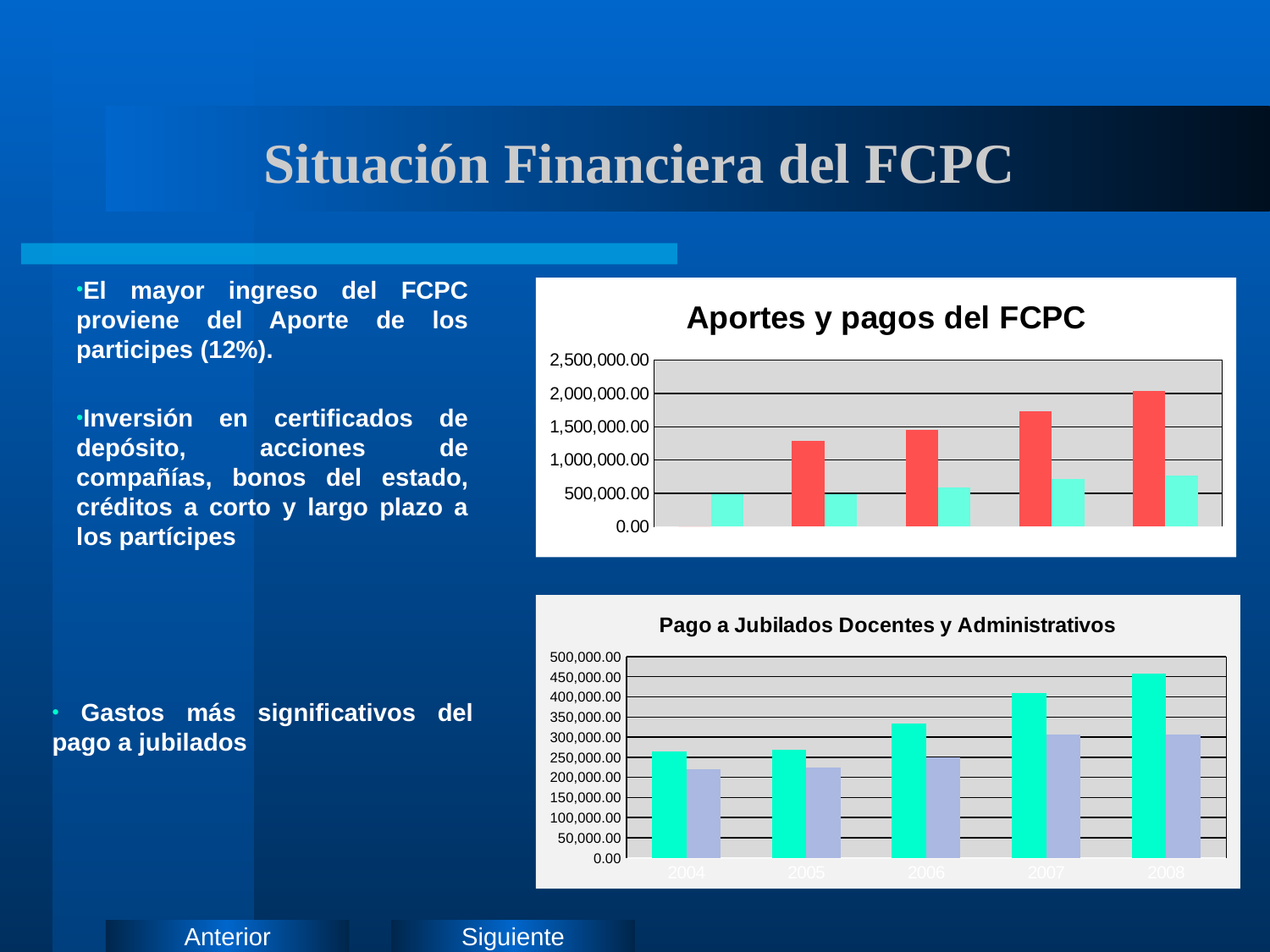
What kind of chart is the 'Aportes y pagos del FCPC' chart? Bar chart In the 'Pago a Jubilados Docentes y Administrativos' chart, which year has the tallest cyan bar? 2008 In the 'Pago a Jubilados Docentes y Administrativos' chart, how many years are shown on the x axis? 5 In the 'Aportes y pagos del FCPC' chart, is the red bar in the rightmost group greater or less than 1,500,000.00? greater In the 'Pago a Jubilados Docentes y Administrativos' chart, for 2008, which bar is taller, the cyan one or the light blue one? The cyan one In the 'Pago a Jubilados Docentes y Administrativos' chart, is the light blue bar for 2004 greater or less than 250,000.00? less In the 'Aportes y pagos del FCPC' chart, how many groups of bars are plotted? 5 In the 'Pago a Jubilados Docentes y Administrativos' chart, do the cyan bars rise or fall from 2004 to 2008? Rise In the 'Pago a Jubilados Docentes y Administrativos' chart, which year has the shortest cyan bar? 2004 What kind of chart is the 'Pago a Jubilados Docentes y Administrativos' chart? Bar chart In the 'Aportes y pagos del FCPC' chart, do the red bars rise or fall from left to right? Rise In the 'Pago a Jubilados Docentes y Administrativos' chart, is the cyan bar for 2008 greater or less than 400,000.00? greater